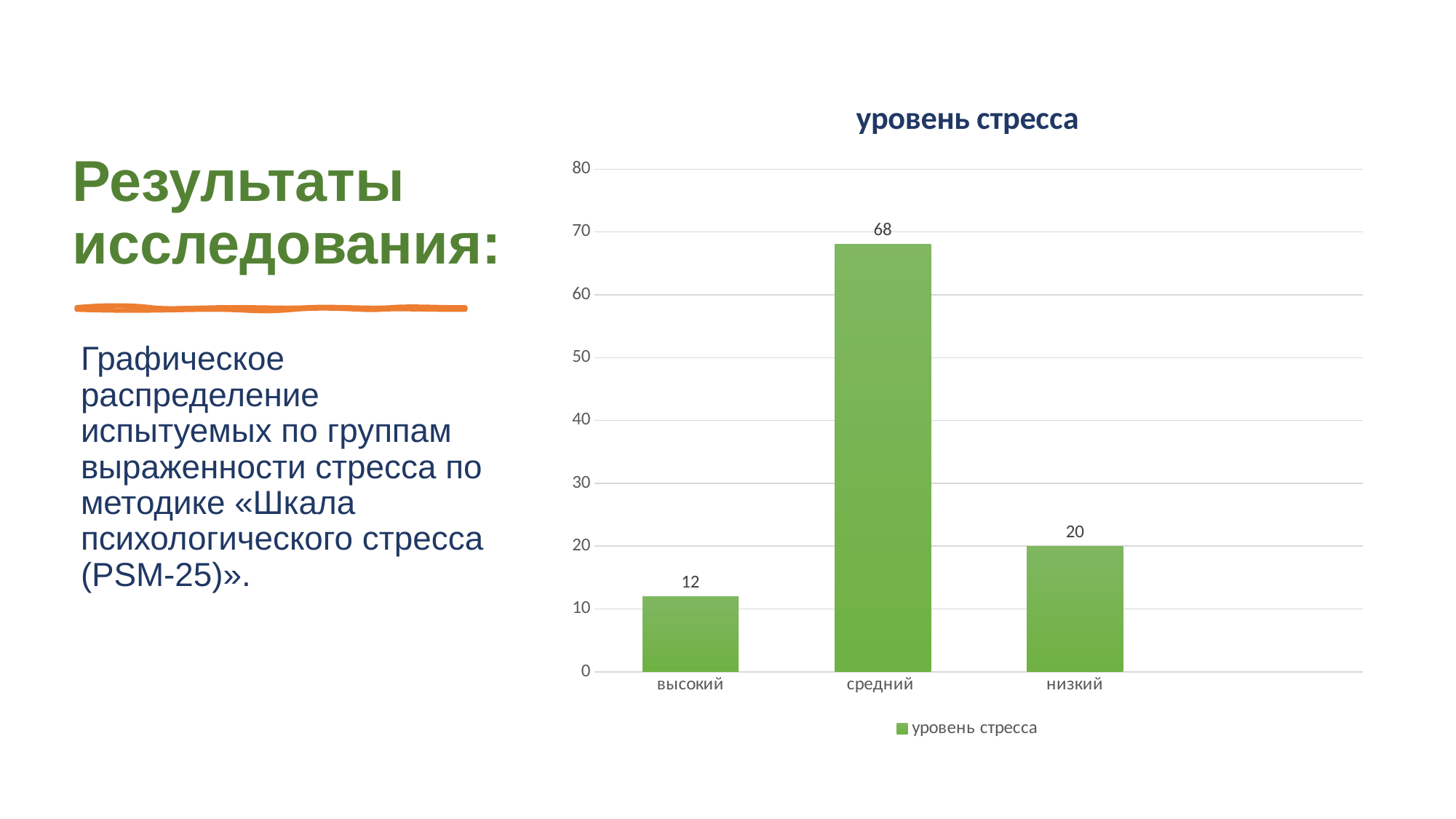
What is the difference between the values for низкий and высокий? 8 What kind of chart is shown on the slide? bar chart What is the value for низкий? 20 What is the difference between the values for средний and низкий? 48 Which category has the highest value? средний How many categories are shown on the x axis? 3 What is the title of the chart? уровень стресса Which is larger, the value for низкий or the value for высокий? низкий Is the value for средний greater or less than 60? greater What is the value for средний? 68 What is the value for высокий? 12 Which category has the lowest value? высокий